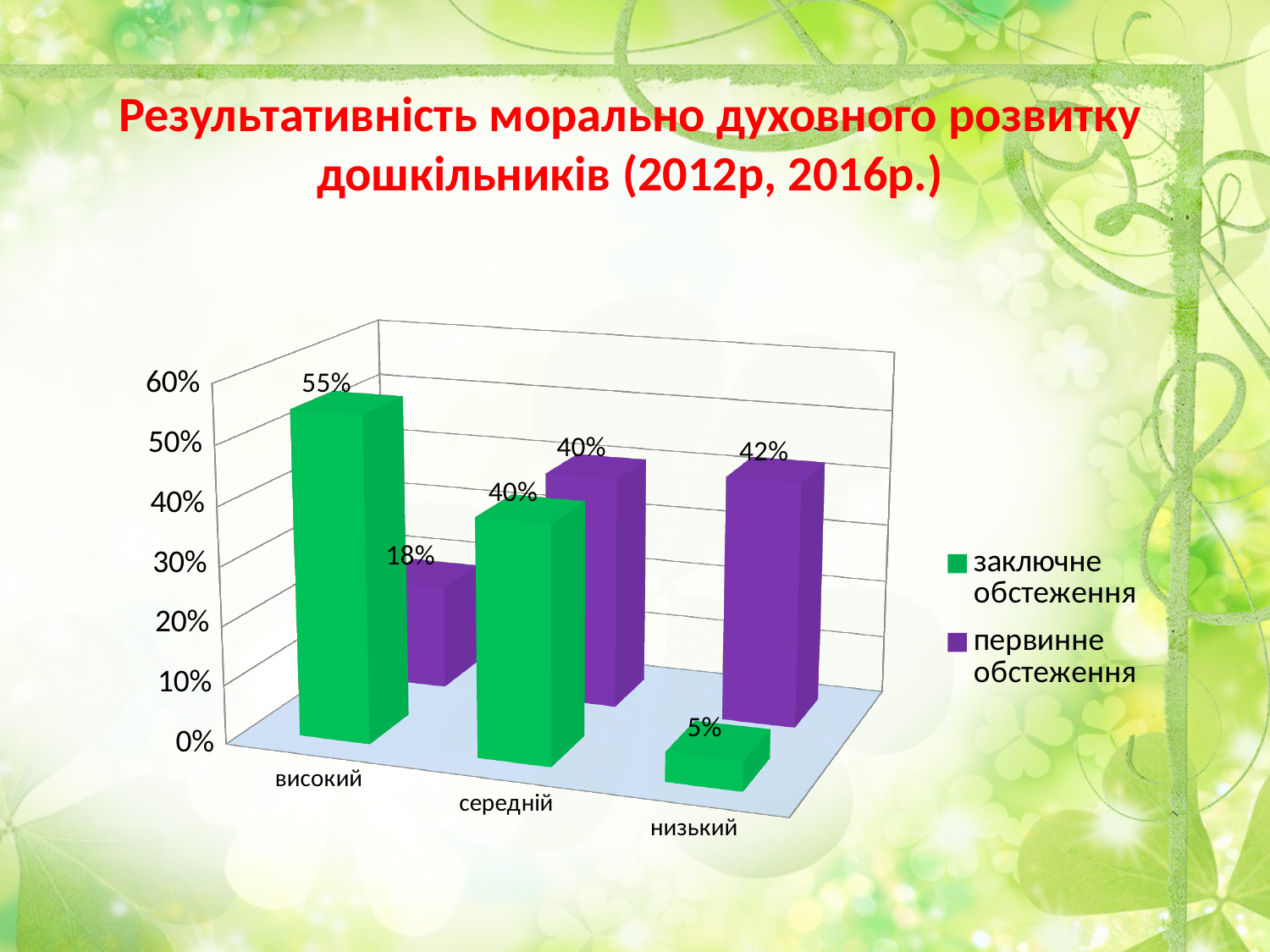
What is the value for заключне обстеження in the низький category? 5% Which category has the highest value for заключне обстеження? високий What is the value for первинне обстеження in the низький category? 42% What is the value for первинне обстеження in the високий category? 18% How many categories are shown on the x axis? 3 In the низький category, which series has the larger value, заключне обстеження or первинне обстеження? первинне обстеження Which category has the lowest value for первинне обстеження? високий What is the value for заключне обстеження in the високий category? 55% How many series does the legend list? 2 What colour represents первинне обстеження in the chart? purple What kind of chart is shown on the slide? bar chart What is the difference between заключне обстеження and первинне обстеження in the високий category? 37%